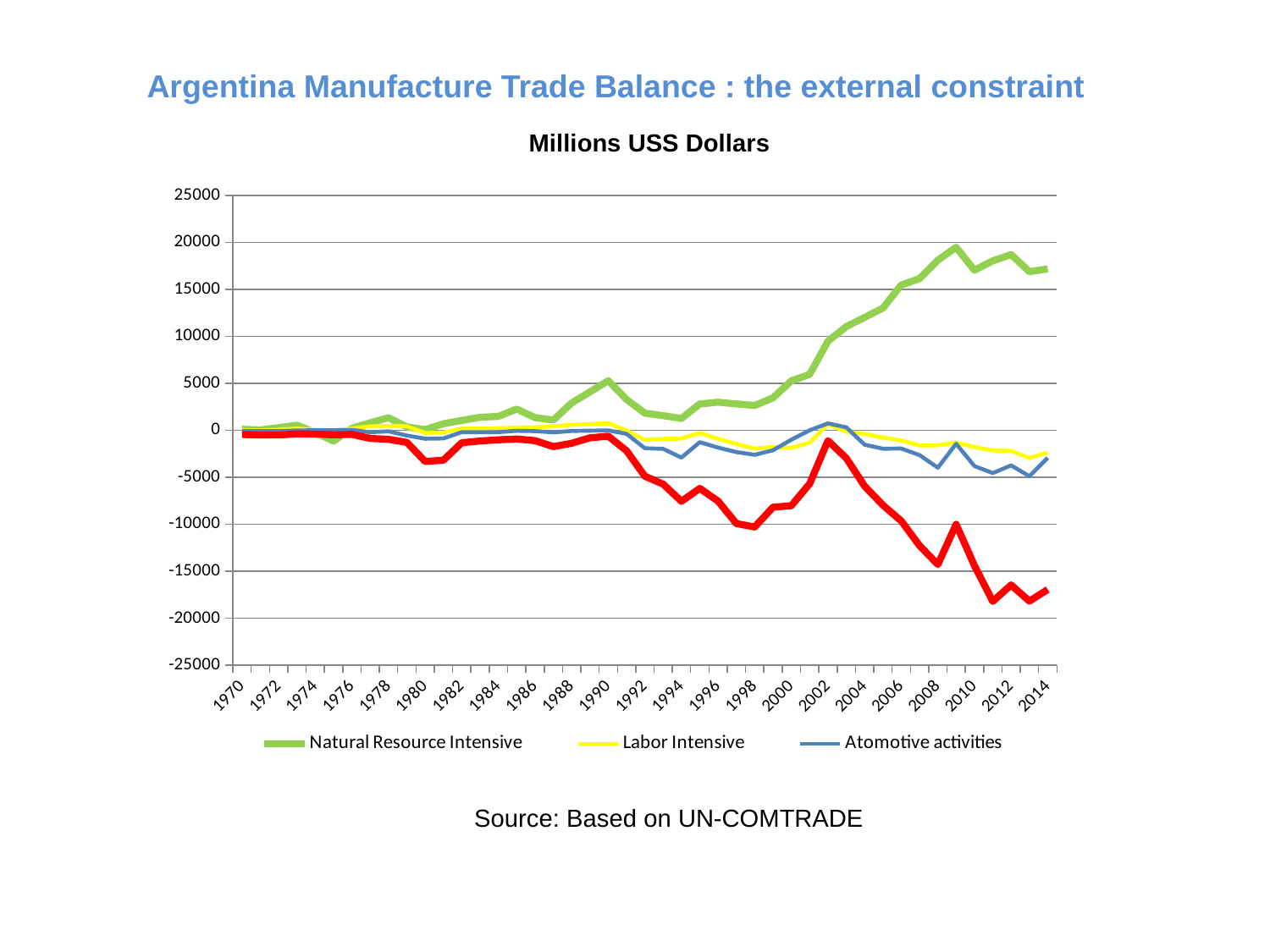
Is the value for Natural Resource Intensive in 2008 greater or less than 10000? greater How many series does the chart's legend list? 3 Is the value for Natural Resource Intensive in 2010 greater or less than 15000? greater Is the value for Labor Intensive in 2014 greater or less than -5000? greater How many year labels are shown on the x axis? 23 In 2014, which is higher: Natural Resource Intensive or Labor Intensive? Natural Resource Intensive What kind of chart is shown on the slide? line chart What is the title printed above the chart? Millions USS Dollars Does the Natural Resource Intensive line rise or fall between 2002 and 2010? rise What colour is the Natural Resource Intensive line? green